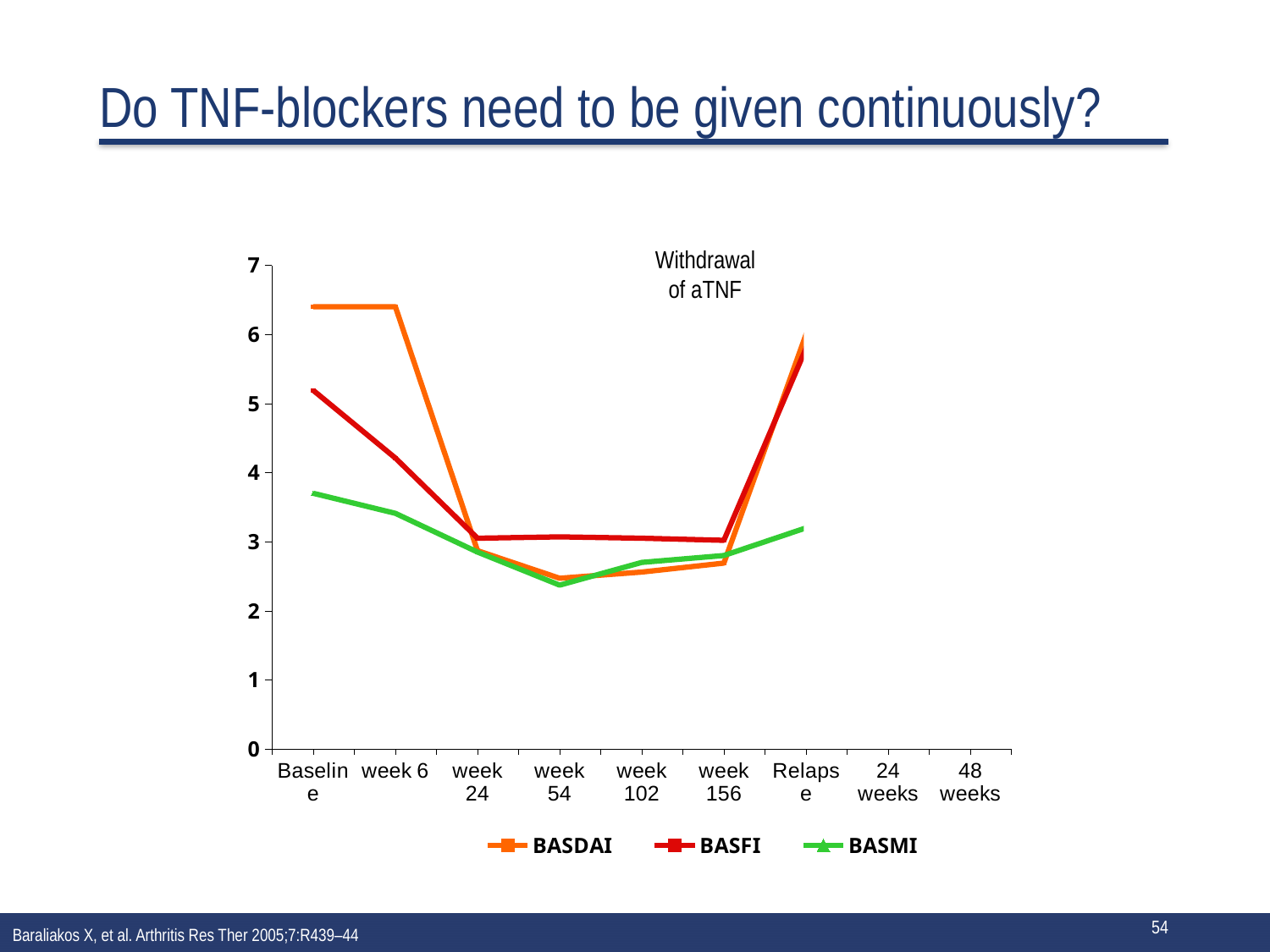
What kind of chart is shown on the slide? line chart Which series has the lowest value at Baseline? BASMI Is the BASFI value at Relapse greater or less than 5? greater How many categories are labelled on the x axis? 9 How many series does the legend list? 3 At Relapse, which is higher, BASFI or BASMI? BASFI Which series has the highest value at Baseline? BASDAI What annotation text is shown above the chart near the Relapse point? Withdrawal of aTNF Does the BASDAI line rise or fall from week 6 to week 24? fall Is the BASMI value at week 54 greater or less than 3? less Is the BASFI value at week 156 greater or less than 4? less